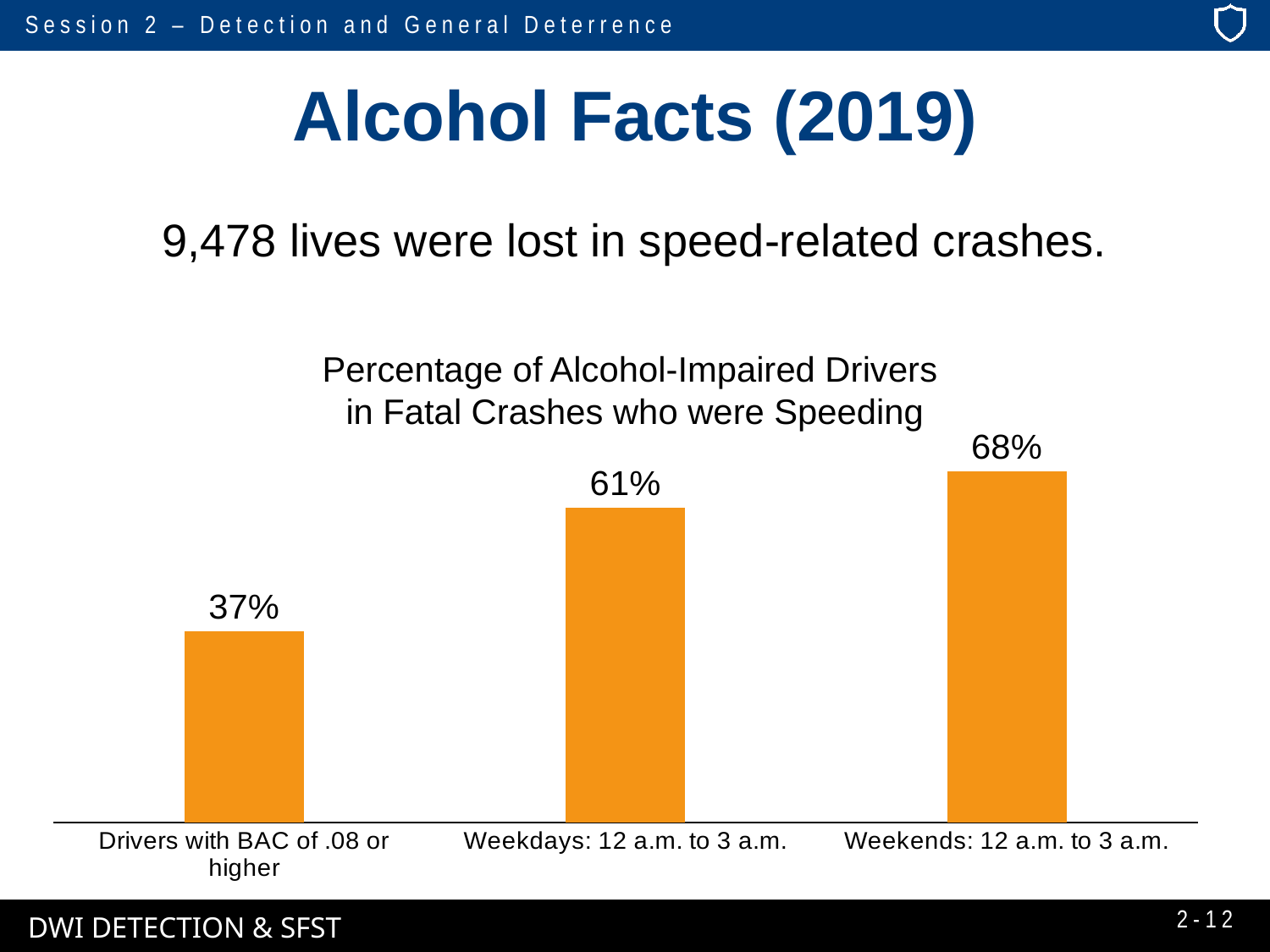
What is the title of the chart? Percentage of Alcohol-Impaired Drivers in Fatal Crashes who were Speeding How many categories are shown in the chart? 3 Which category has the lowest percentage? Drivers with BAC of .08 or higher What is the value for Drivers with BAC of .08 or higher? 37% What is the value for Weekdays: 12 a.m. to 3 a.m.? 61% Which category has the highest percentage? Weekends: 12 a.m. to 3 a.m. Do the values rise or fall from left to right across the categories? Rise What kind of chart is shown on the slide? Bar chart What is the difference between the Weekends: 12 a.m. to 3 a.m. value and the Weekdays: 12 a.m. to 3 a.m. value? 7% What is the difference between the Weekdays: 12 a.m. to 3 a.m. value and the Drivers with BAC of .08 or higher value? 24% What is the value for Weekends: 12 a.m. to 3 a.m.? 68% Which is larger: the value for Weekdays: 12 a.m. to 3 a.m. or the value for Drivers with BAC of .08 or higher? Weekdays: 12 a.m. to 3 a.m.